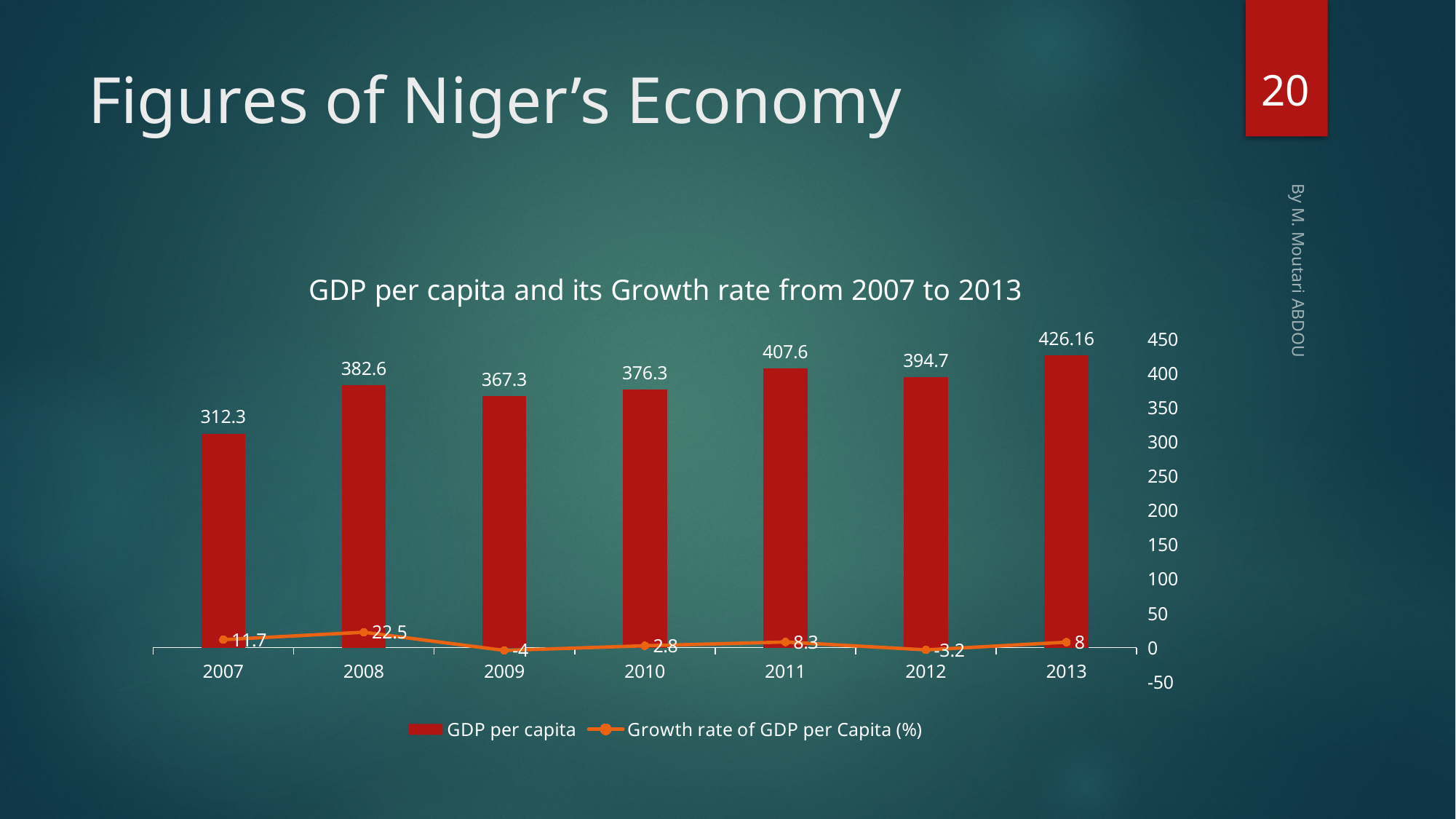
What is the difference in GDP per capita between 2011 and 2010? 31.3 What is the title of the chart? GDP per capita and its Growth rate from 2007 to 2013 What is the growth rate of GDP per capita (%) for 2008? 22.5 How many series does the legend list? 2 Which year has the larger GDP per capita, 2008 or 2012? 2012 Which year has the lowest growth rate of GDP per capita (%)? 2009 What is the GDP per capita value for 2013? 426.16 Which year has the highest GDP per capita? 2013 What is the GDP per capita value for 2007? 312.3 What kind of chart is used to show GDP per capita? Bar chart How many years are shown on the x axis? 7 What is the growth rate of GDP per capita (%) for 2012? -3.2